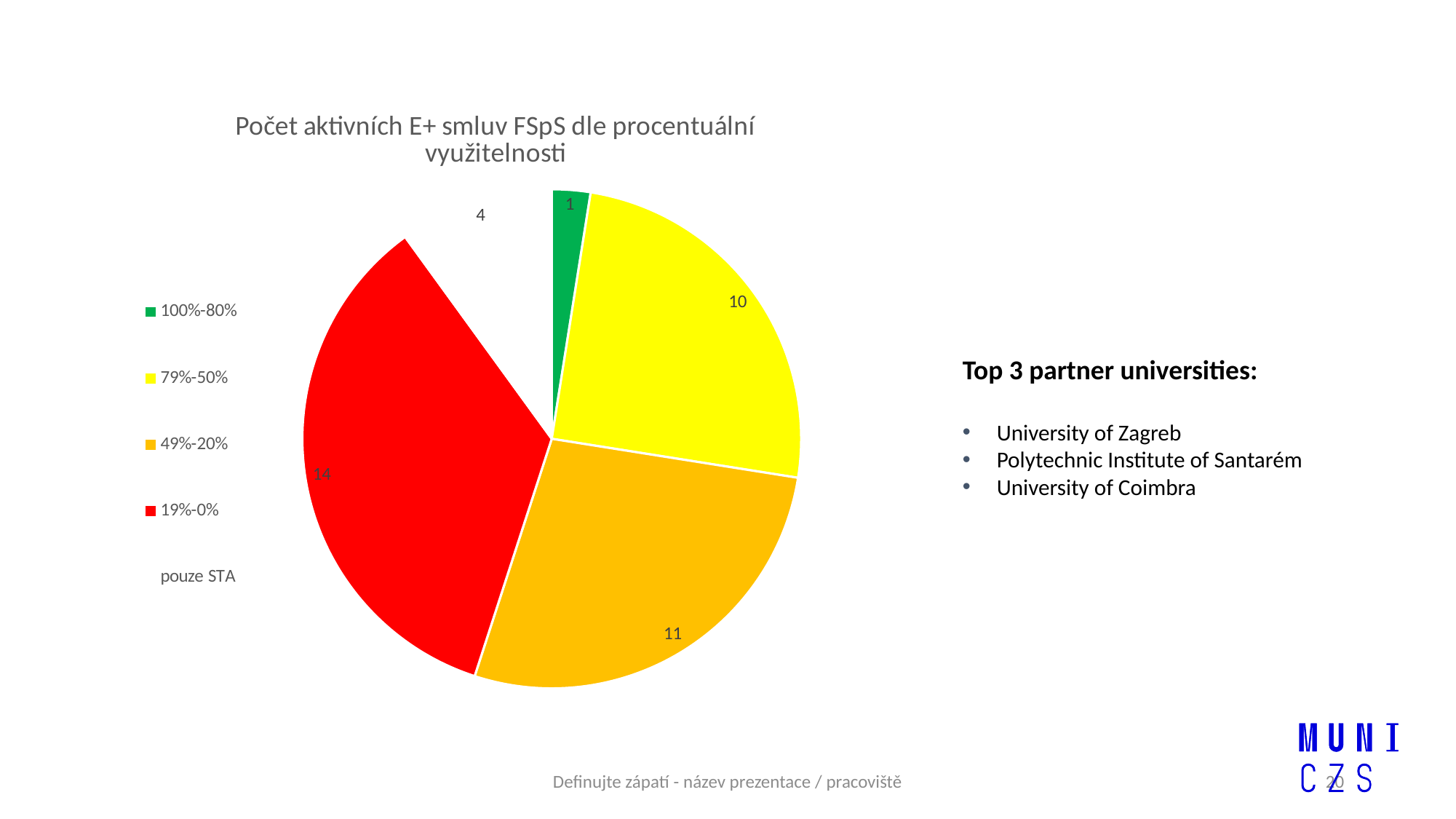
How many categories does the legend list? 5 What is the value for the 79%-50% category? 10 What is the value for the 19%-0% category? 14 What is the value for the 49%-20% category? 11 What is the difference between the values for 19%-0% and 79%-50%? 4 Which category has the smallest slice of the pie? 100%-80% What is the value for the pouze STA category? 4 What is the value for the 100%-80% category? 1 Which is larger, the value for 49%-20% or the value for pouze STA? 49%-20% Which category has the largest slice of the pie? 19%-0% What type of chart is shown on the slide? pie chart What share of the pie does the 19%-0% slice represent? 35%